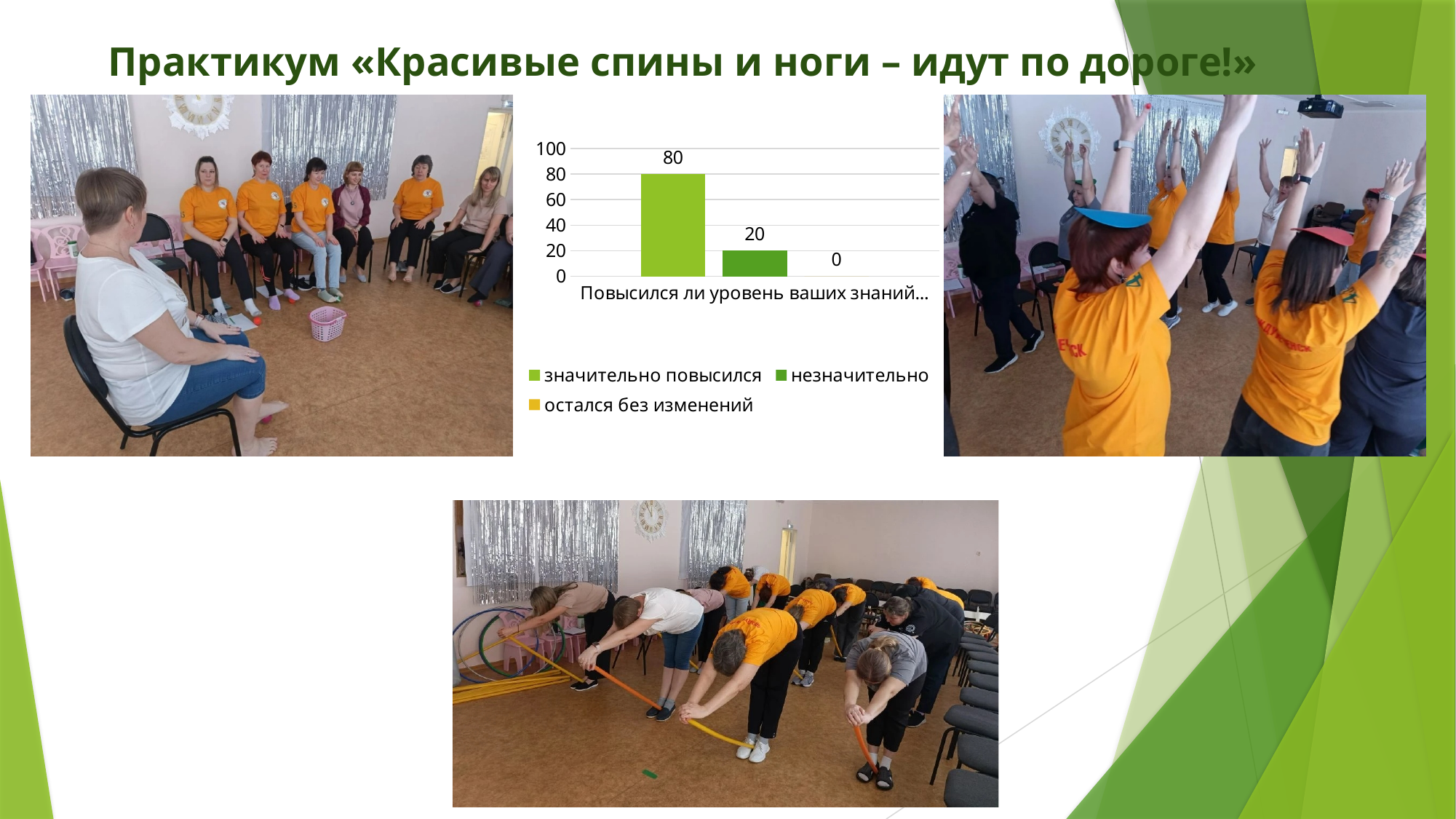
Is the value for "значительно повысился" greater or less than 60? greater What is the difference between the values for "значительно повысился" and "незначительно"? 60 Which series has the lowest value in the chart? остался без изменений What value is shown for the series "значительно повысился"? 80 Which series has the highest value in the chart? значительно повысился Which is larger: the value for "значительно повысился" or the value for "незначительно"? значительно повысился How many series does the legend list? 3 What is the total of the three values plotted in the chart? 100 What value is shown for the series "остался без изменений"? 0 What kind of chart is shown on the slide? bar chart What value is shown for the series "незначительно"? 20 What is the highest value shown on the vertical axis of the chart? 100